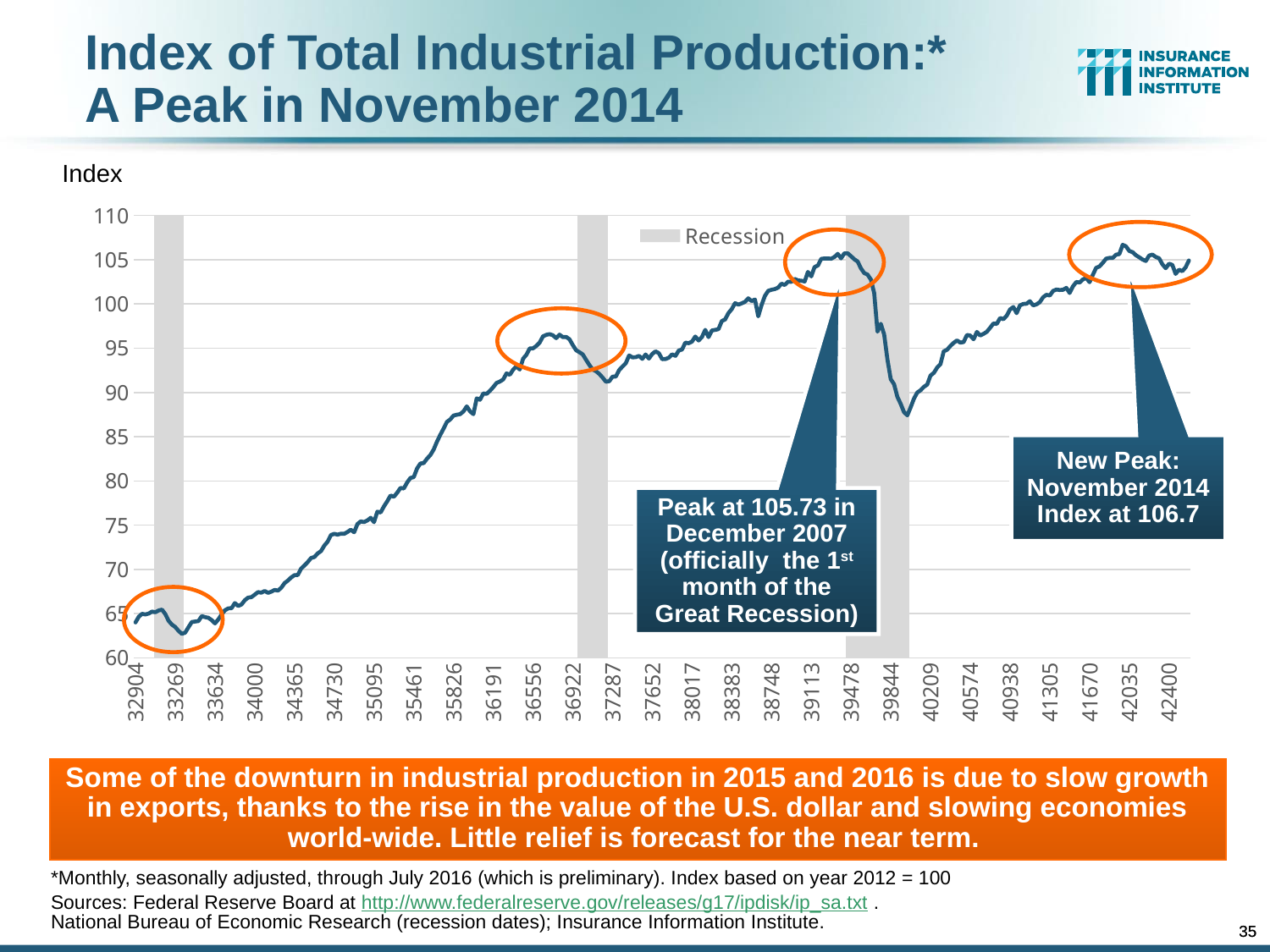
What do the gray shaded vertical bands on the chart represent? Recession periods What kind of chart is shown on the slide? line chart Is the lowest index value reached after the Great Recession (near x-axis label 39844) greater or less than 90? less Which peak is higher, December 2007 or November 2014? November 2014 Is the index value at the start of the series (x-axis label 32904) greater or less than 70? less By how much does the November 2014 peak (106.7) exceed the December 2007 peak (105.73)? 0.97 Over the full period shown, does the index generally rise or fall from left to right? rise What was the value of the index at its peak in December 2007? 105.73 What entry does the chart legend list? Recession How many gray recession bands are shaded on the chart? 3 What was the value of the index at the new peak in November 2014? 106.7 What is the highest value shown on the y-axis? 110